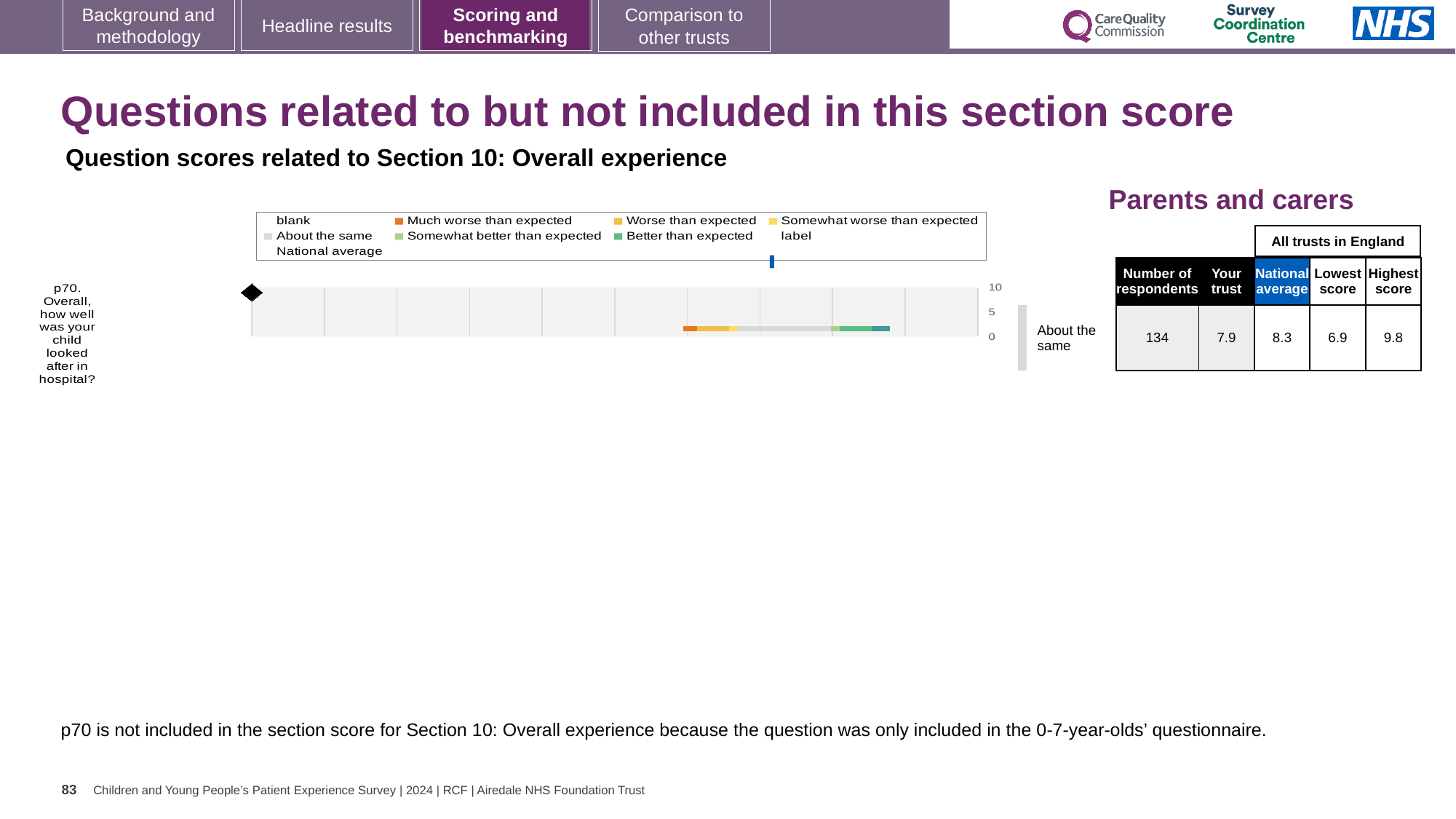
How many questions are plotted in the chart? 1 Which is larger for p70, the 'Your trust' score or the national average? National average What is the difference between the highest score and the lowest score for p70? 2.9 What is the highest score among all trusts in England for p70? 9.8 What is the 'Your trust' score for p70? 7.9 What is the lowest score among all trusts in England for p70? 6.9 What kind of chart is used to show the p70 question score? bar chart What is the national average score for p70? 8.3 How many respondents answered p70? 134 How many legend entries in the chart contain the words 'than expected'? 5 Which question is plotted in the chart? p70. Overall, how well was your child looked after in hospital? What benchmark category is shown next to the bar for p70? About the same